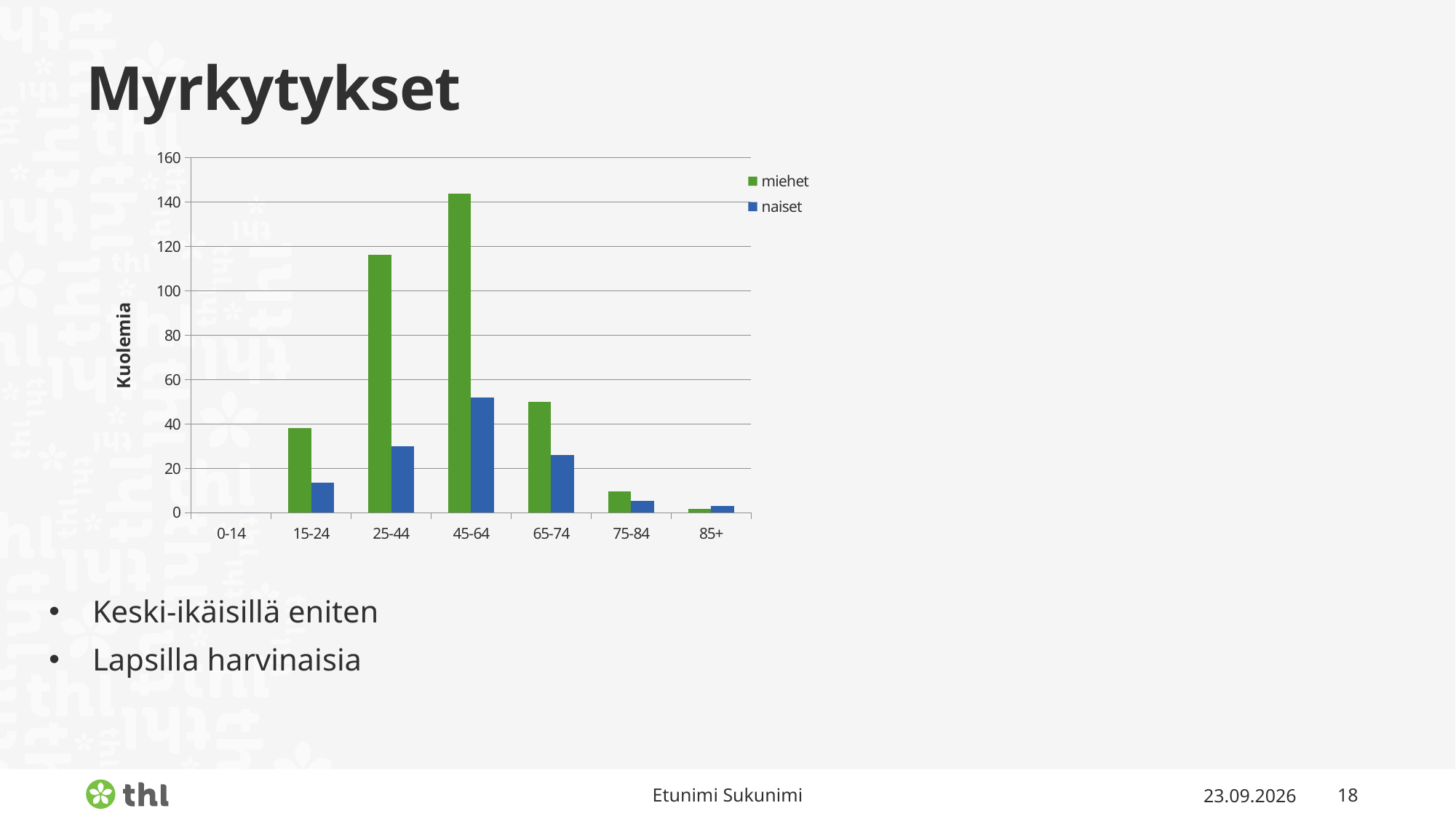
In the 25-44 age group, which series has the larger value, miehet or naiset? miehet Is the value for naiset in the 45-64 age group greater or less than 40? greater Which age group has the highest value for miehet? 45-64 Which age group has the highest value for naiset? 45-64 How many age-group categories are shown on the x axis? 7 What kind of chart is shown on the slide? bar chart Which age group has the lowest value for miehet? 0-14 What is the title of the vertical axis? Kuolemia Is the value for miehet in the 25-44 age group greater or less than 100? greater Is the value for miehet in the 65-74 age group greater or less than 60? less How many series does the legend list? 2